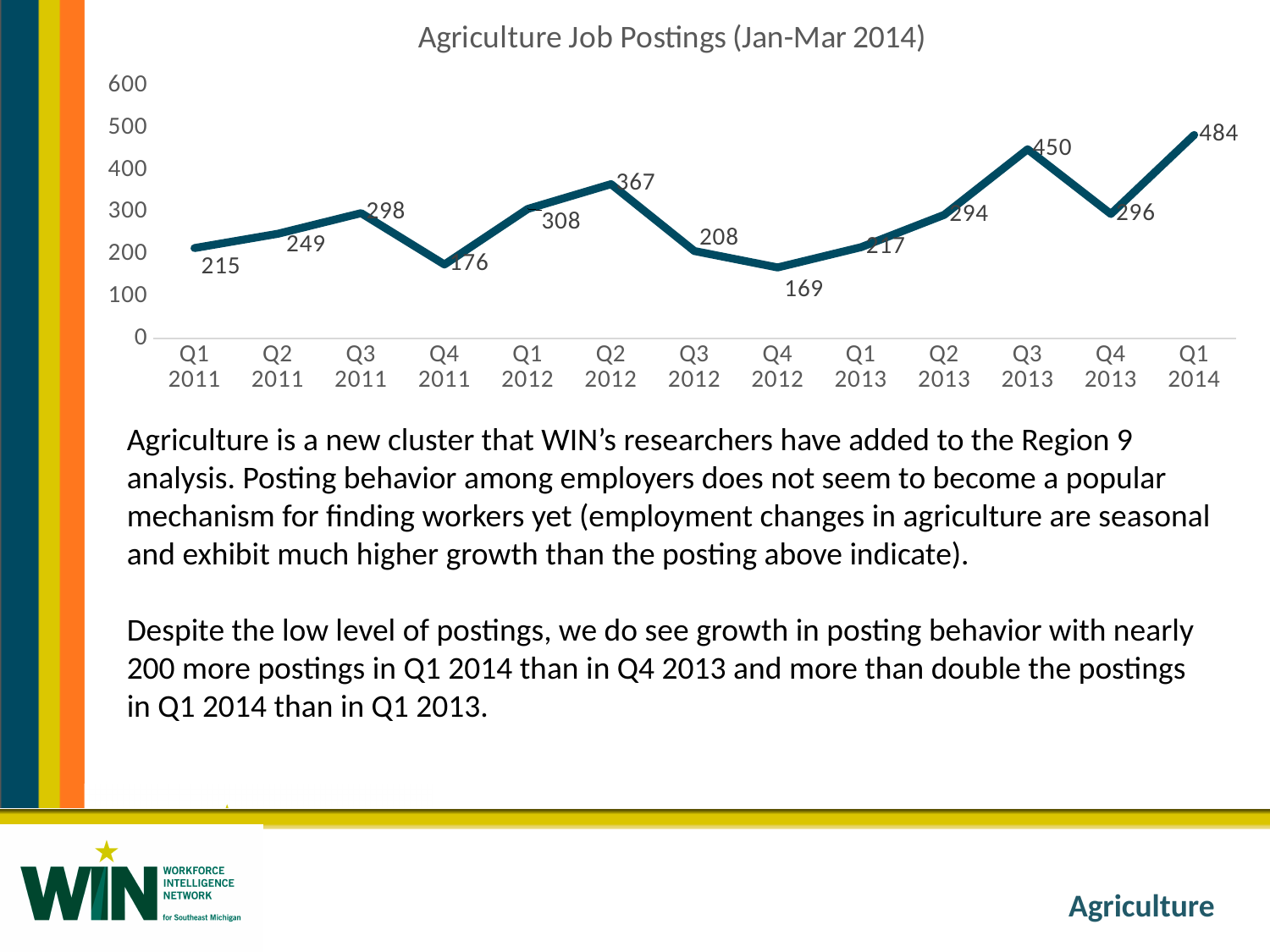
Which quarter has the lowest number of job postings? Q4 2012 What is the value for Q1 2014? 484 What is the value for Q3 2013? 450 What is the difference between the values for Q1 2014 and Q4 2013? 188 Which is larger, the value for Q3 2011 or the value for Q2 2013? Q3 2011 What is the value for Q4 2012? 169 What is the title of the chart? Agriculture Job Postings (Jan-Mar 2014) What kind of chart is shown on the slide? line chart What is the difference between the values for Q2 2012 and Q3 2012? 159 Is the value for Q3 2013 greater or less than 400? greater How many quarters are plotted on the chart? 13 Which quarter has the highest number of job postings? Q1 2014